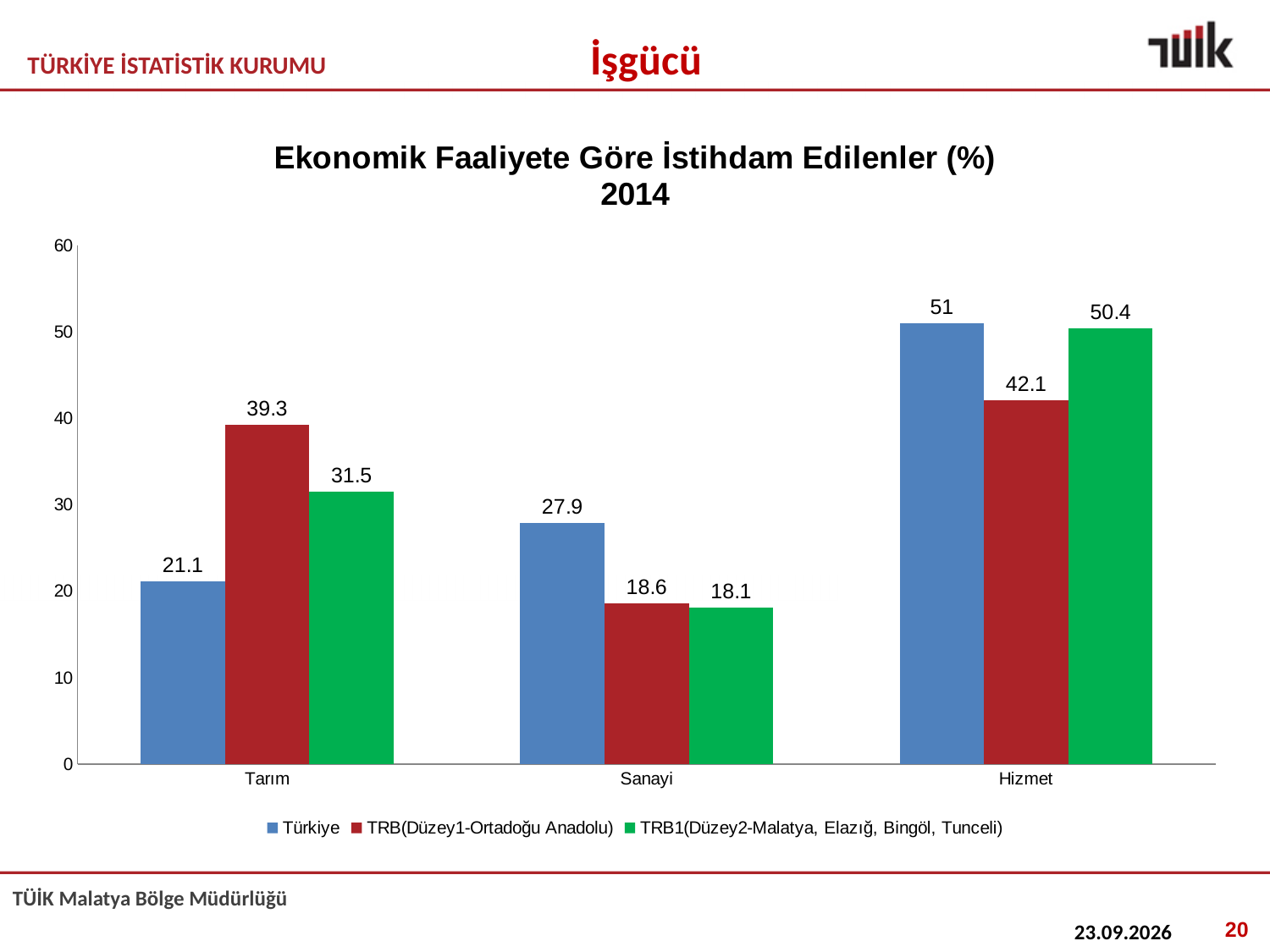
What is the difference between the TRB(Düzey1-Ortadoğu Anadolu) and Türkiye values in the Tarım category? 18.2 Which category has the highest value for Türkiye? Hizmet What is the value for TRB1(Düzey2-Malatya, Elazığ, Bingöl, Tunceli) in the Sanayi category? 18.1 What is the value for TRB(Düzey1-Ortadoğu Anadolu) in the Hizmet category? 42.1 How many categories are shown on the x axis? 3 In the Hizmet category, which is larger: the Türkiye value or the TRB1(Düzey2-Malatya, Elazığ, Bingöl, Tunceli) value? Türkiye Is the value for TRB1(Düzey2-Malatya, Elazığ, Bingöl, Tunceli) in Tarım greater or less than 30? greater What is the title of the chart? Ekonomik Faaliyete Göre İstihdam Edilenler (%) 2014 Which category has the lowest value for TRB(Düzey1-Ortadoğu Anadolu)? Sanayi What kind of chart is shown on the slide? bar chart What is the value for Türkiye in the Tarım category? 21.1 How many series does the legend list? 3